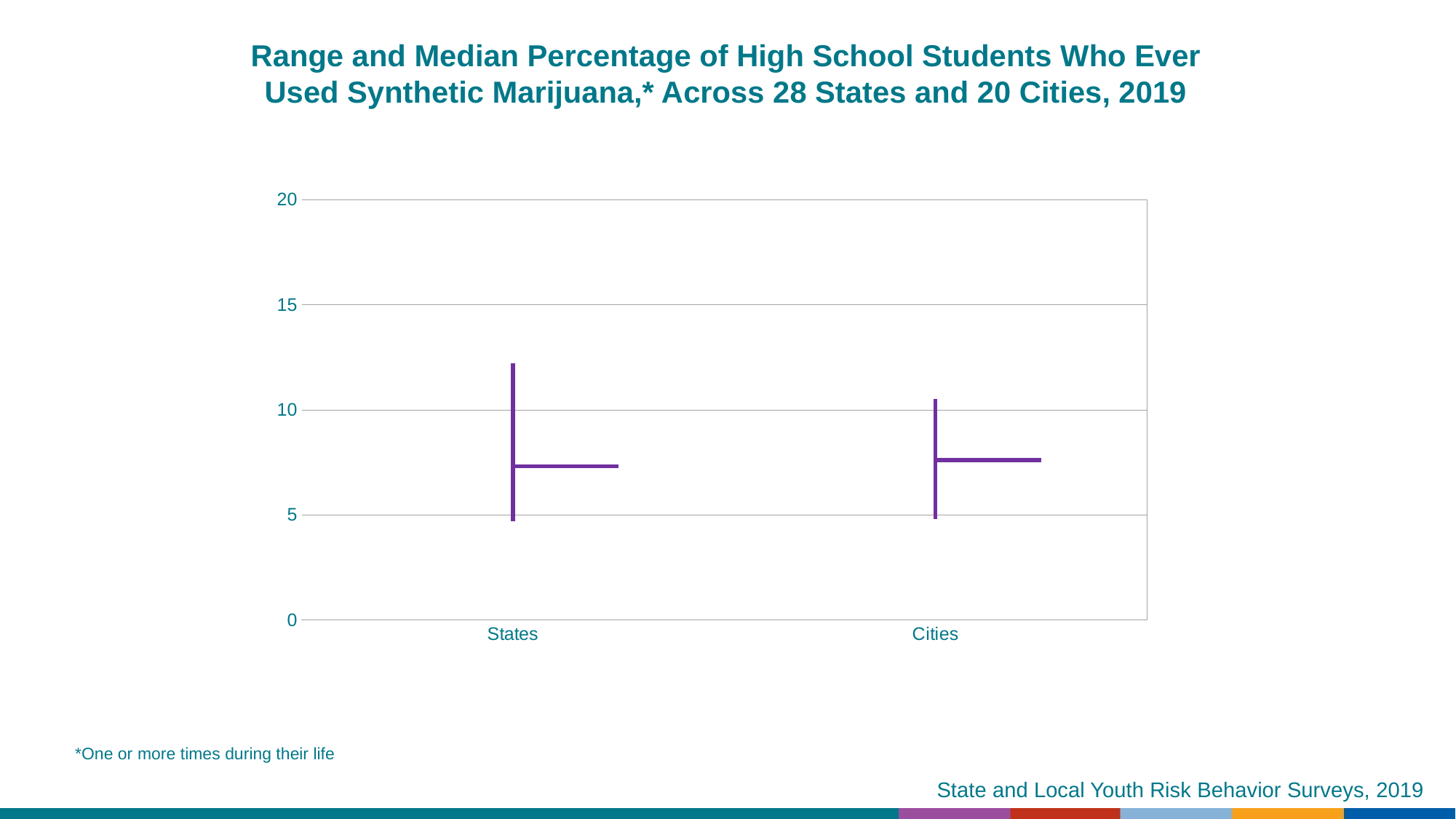
What are the two category labels on the x axis of the chart? States and Cities Which category has the higher top of its range, States or Cities? States What is the highest value shown on the y axis of the chart? 20 Is the median value for States greater or less than 10? less Is the top of the range for Cities greater or less than 15? less Is the top of the range for States greater or less than 15? less How many categories are shown on the x axis of the chart? 2